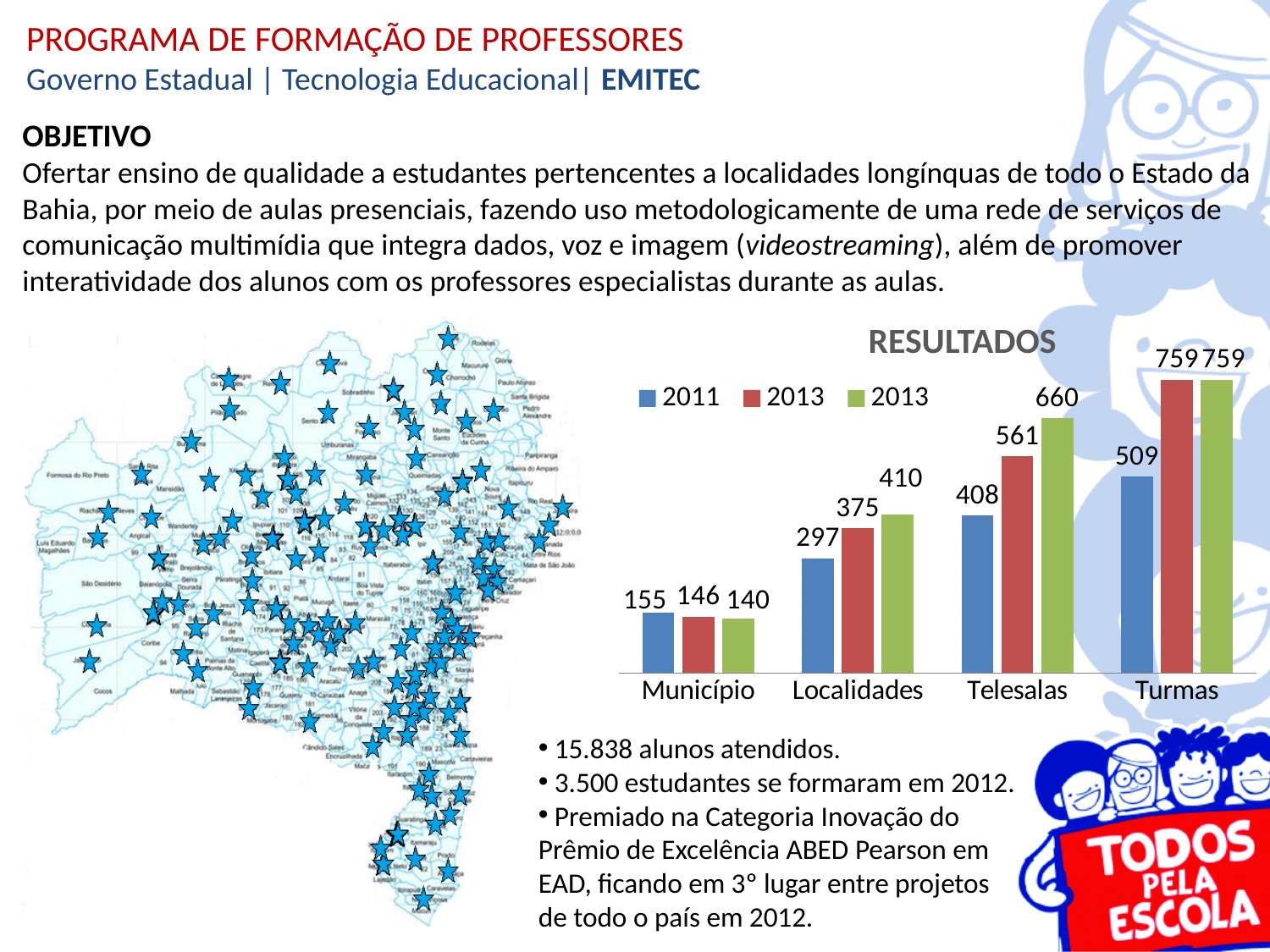
In the RESULTADOS chart, what is the value of the red 2013 series for Município? 146 How many series does the legend of the RESULTADOS chart list? 3 In the RESULTADOS chart, which category has the lowest value in the green 2013 series? Município In the RESULTADOS chart, do the 2011 values rise or fall from Município to Turmas? rise What is the title of the chart on the slide? RESULTADOS In the RESULTADOS chart, what is the difference between the green 2013 value and the 2011 value for Telesalas? 252 In the RESULTADOS chart, what is the 2011 value for Telesalas? 408 In the RESULTADOS chart, which is larger for Localidades: the 2011 value or the red 2013 value? the red 2013 value In the RESULTADOS chart, what is the value of the green 2013 series for Localidades? 410 How many categories are shown on the x axis of the RESULTADOS chart? 4 In the RESULTADOS chart, which category has the highest 2011 value? Turmas What type of chart is shown under the title RESULTADOS? bar chart